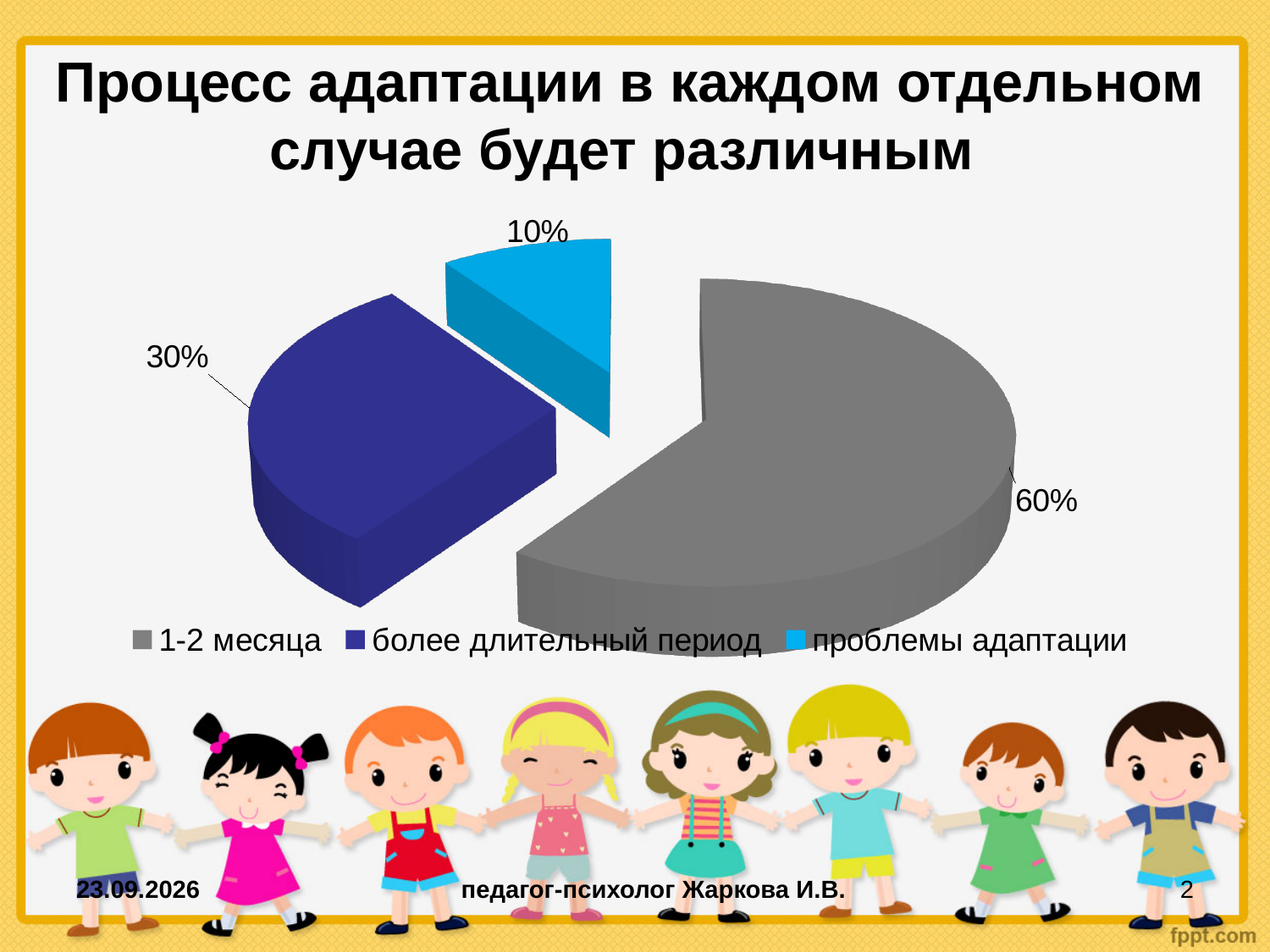
What share of the pie does the "1-2 месяца" slice represent? 60% Which legend entry is shown in grey? 1-2 месяца What share of the pie does the "проблемы адаптации" slice represent? 10% Which is larger: the "более длительный период" slice or the "проблемы адаптации" slice? более длительный период What is the difference in percentage points between the "более длительный период" slice and the "проблемы адаптации" slice? 20% What colour is the "проблемы адаптации" slice? light blue Which category has the smallest slice of the pie? проблемы адаптации What kind of chart is shown on the slide? pie chart Which category has the largest slice of the pie? 1-2 месяца What share of the pie does the "более длительный период" slice represent? 30% How many slices does the pie chart have? 3 What is the difference in percentage points between the "1-2 месяца" slice and the "более длительный период" slice? 30%